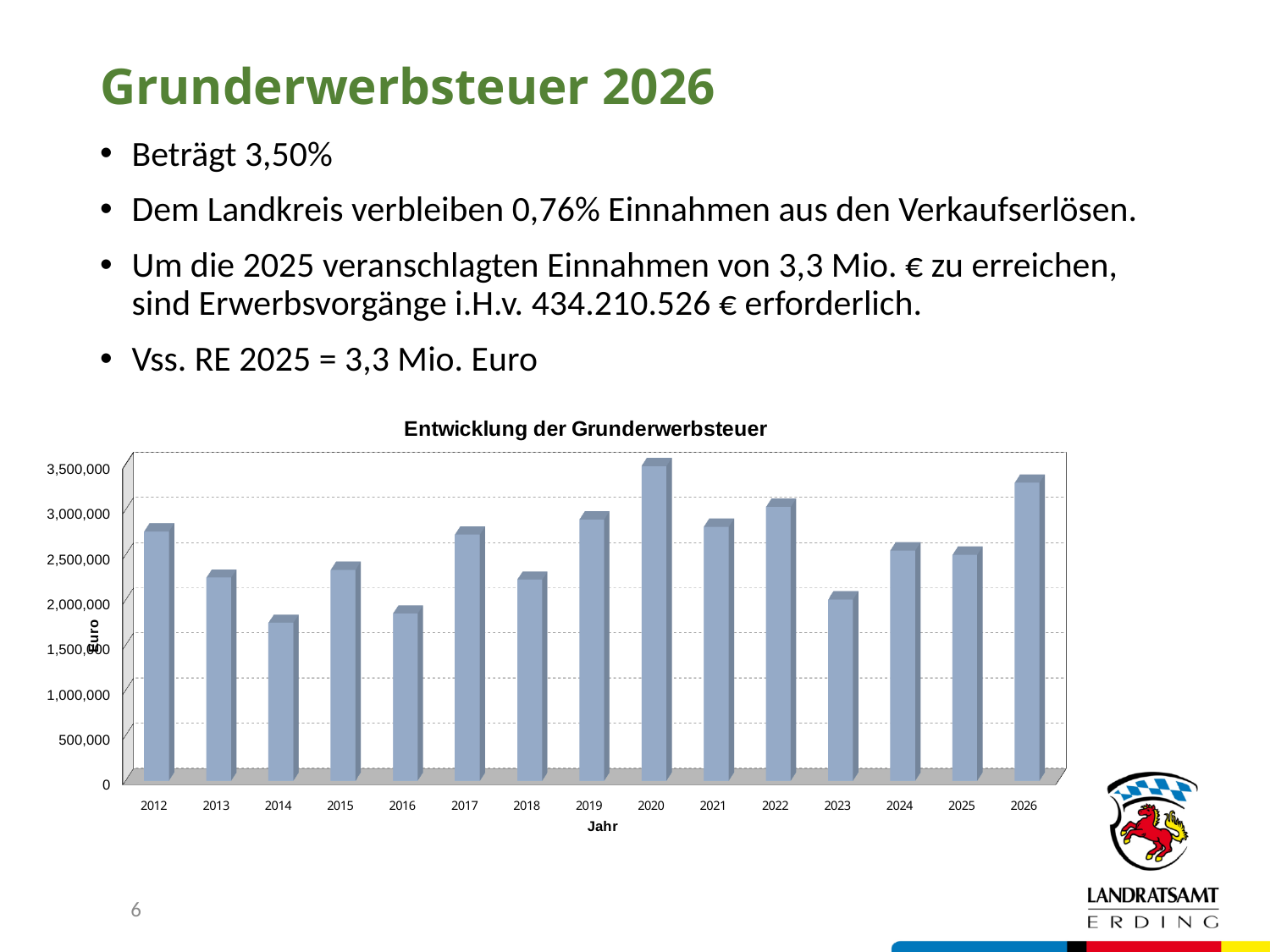
Which year has the highest value in the chart? 2020 Is the value for 2014 greater or less than 2,000,000? less How many years are shown on the x axis of the chart? 15 Is the value for 2026 greater or less than 3,000,000? greater What is the title of the chart? Entwicklung der Grunderwerbsteuer What is the label of the x axis of the chart? Jahr Do the values rise or fall from 2012 to 2014? fall Is the value for 2017 greater or less than 2,500,000? greater Which year has the lowest value in the chart? 2014 What kind of chart is shown on the slide? bar chart Which year has the larger value, 2025 or 2026? 2026